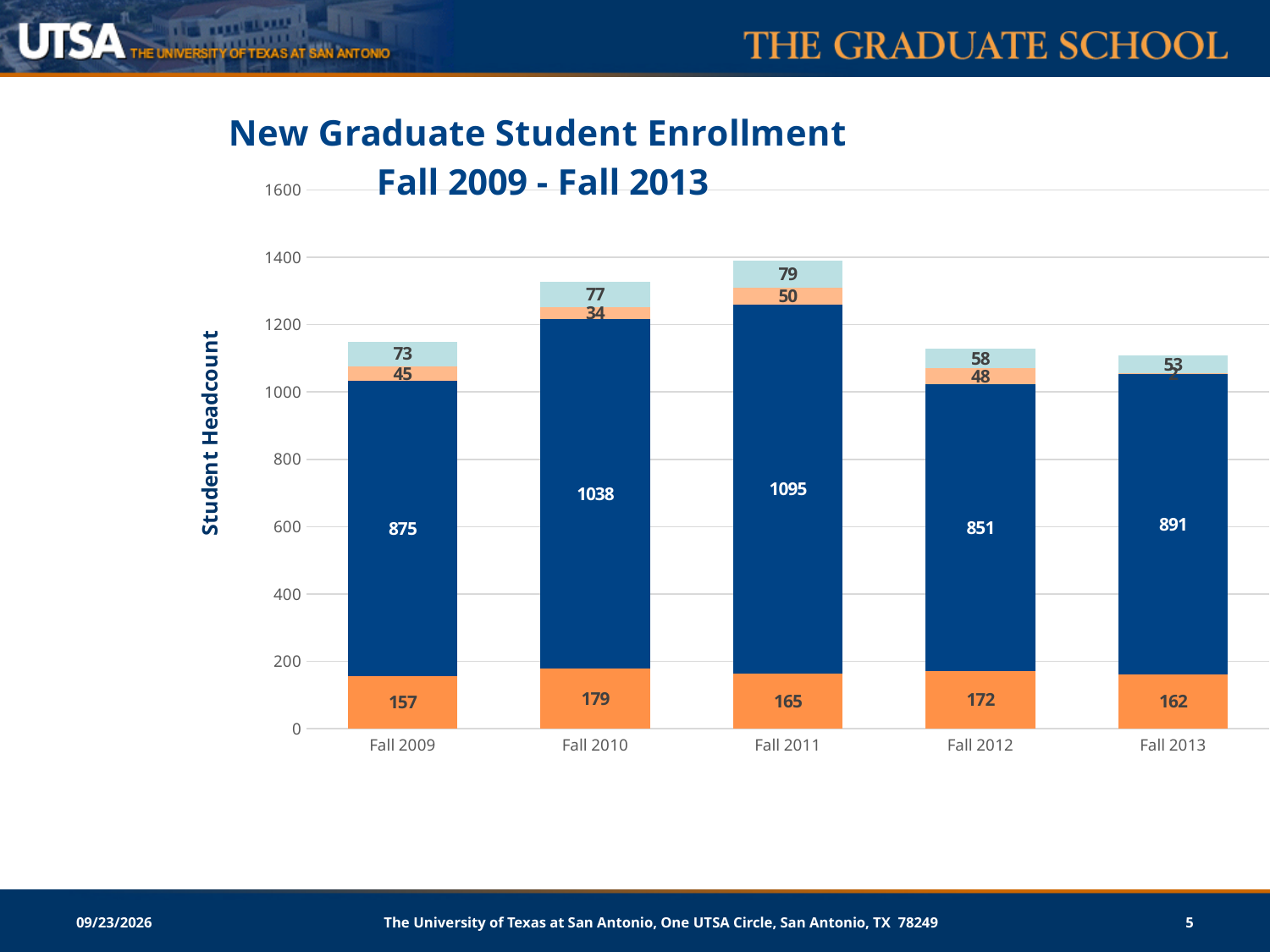
What is the total headcount for the Fall 2009 stacked bar? 1150 Is the total height of the Fall 2012 bar greater or less than 1200? less What kind of chart is shown on the slide? Stacked bar chart What is the value of the light blue top segment for Fall 2009? 73 What is the total headcount for the Fall 2011 stacked bar? 1389 Which is larger, the bottom orange segment for Fall 2012 or for Fall 2013? Fall 2012 Which semester has the smallest dark blue segment? Fall 2012 Which semester has the largest dark blue segment? Fall 2011 What is the value of the bottom orange segment for Fall 2010? 179 What is the difference between the dark blue segment values for Fall 2011 and Fall 2010? 57 What is the value of the dark blue segment for Fall 2011? 1095 How many semesters (categories) are shown on the x axis? 5